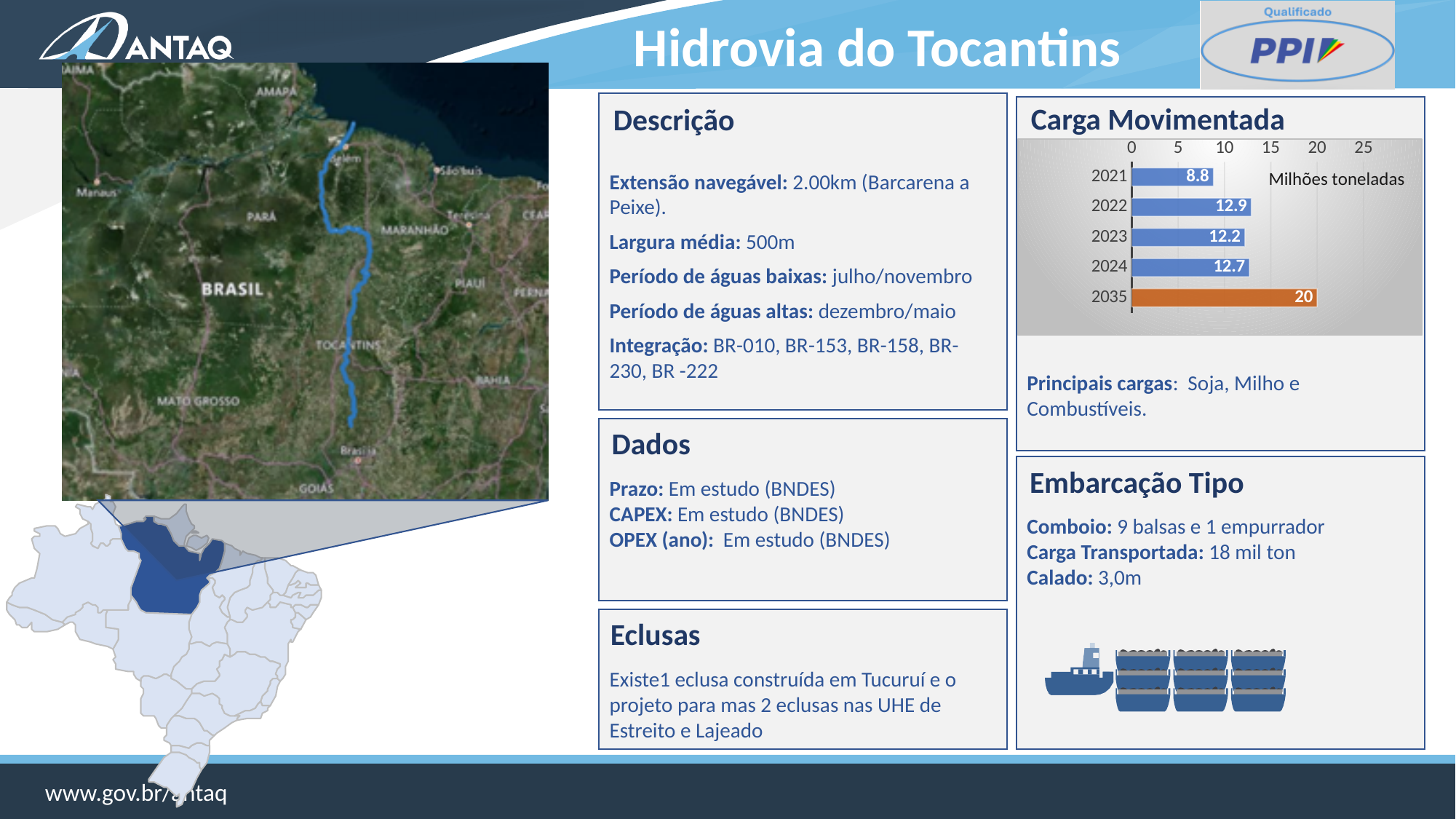
What kind of chart is the Carga Movimentada chart? bar chart What is the value for 2021 in the Carga Movimentada chart? 8.8 Which year has the lowest value in the Carga Movimentada chart? 2021 Is the value for 2021 in the Carga Movimentada chart greater or less than 10? less What is the value for 2022 in the Carga Movimentada chart? 12.9 Which is larger in the Carga Movimentada chart, the value for 2022 or the value for 2024? 2022 Which year has the highest value in the Carga Movimentada chart? 2035 How many years are shown in the Carga Movimentada chart? 5 What is the difference between the values for 2035 and 2024 in the Carga Movimentada chart? 7.3 What unit is indicated on the Carga Movimentada chart? Milhões toneladas What is the difference between the values for 2022 and 2023 in the Carga Movimentada chart? 0.7 What is the value for 2035 in the Carga Movimentada chart? 20